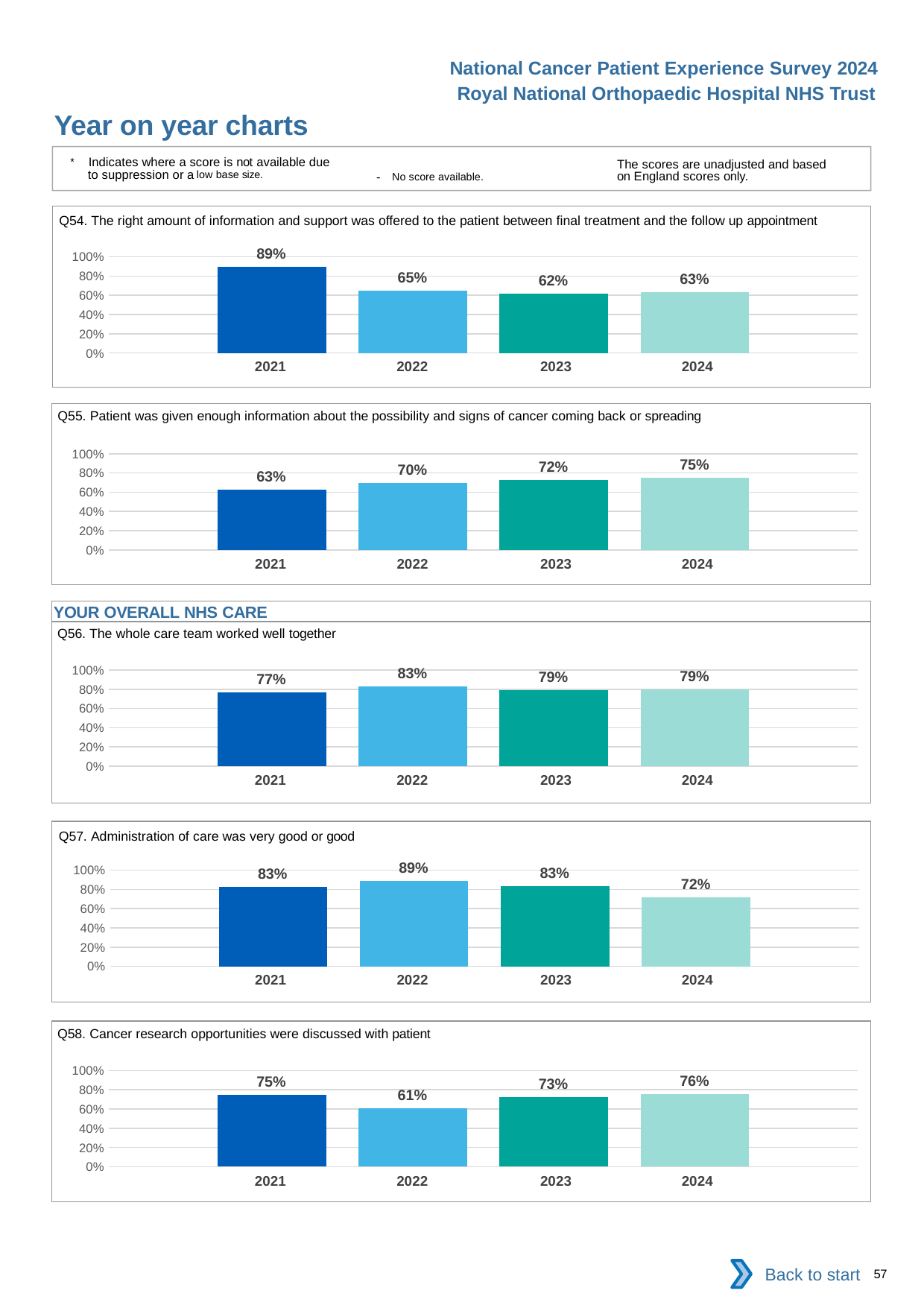
How many bars are in the Q58 chart? 4 In the Q58 chart, what is the value for 2022? 61% In the Q55 chart, what is the value for 2024? 75% In the Q54 chart, what is the value for 2021? 89% In the Q56 chart, what is the value for 2021? 77% In the Q57 chart, what is the difference between the 2022 and 2024 values? 17% In the Q57 chart, which is larger, the value for 2022 or the value for 2024? 2022 In the Q55 chart, do the values rise or fall from 2021 to 2024? rise What type of chart is the Q54 chart? bar chart In the Q56 chart, which year has the highest value? 2022 In the Q54 chart, which year has the lowest value? 2023 In the Q55 chart, what is the difference between the 2024 and 2021 values? 12%